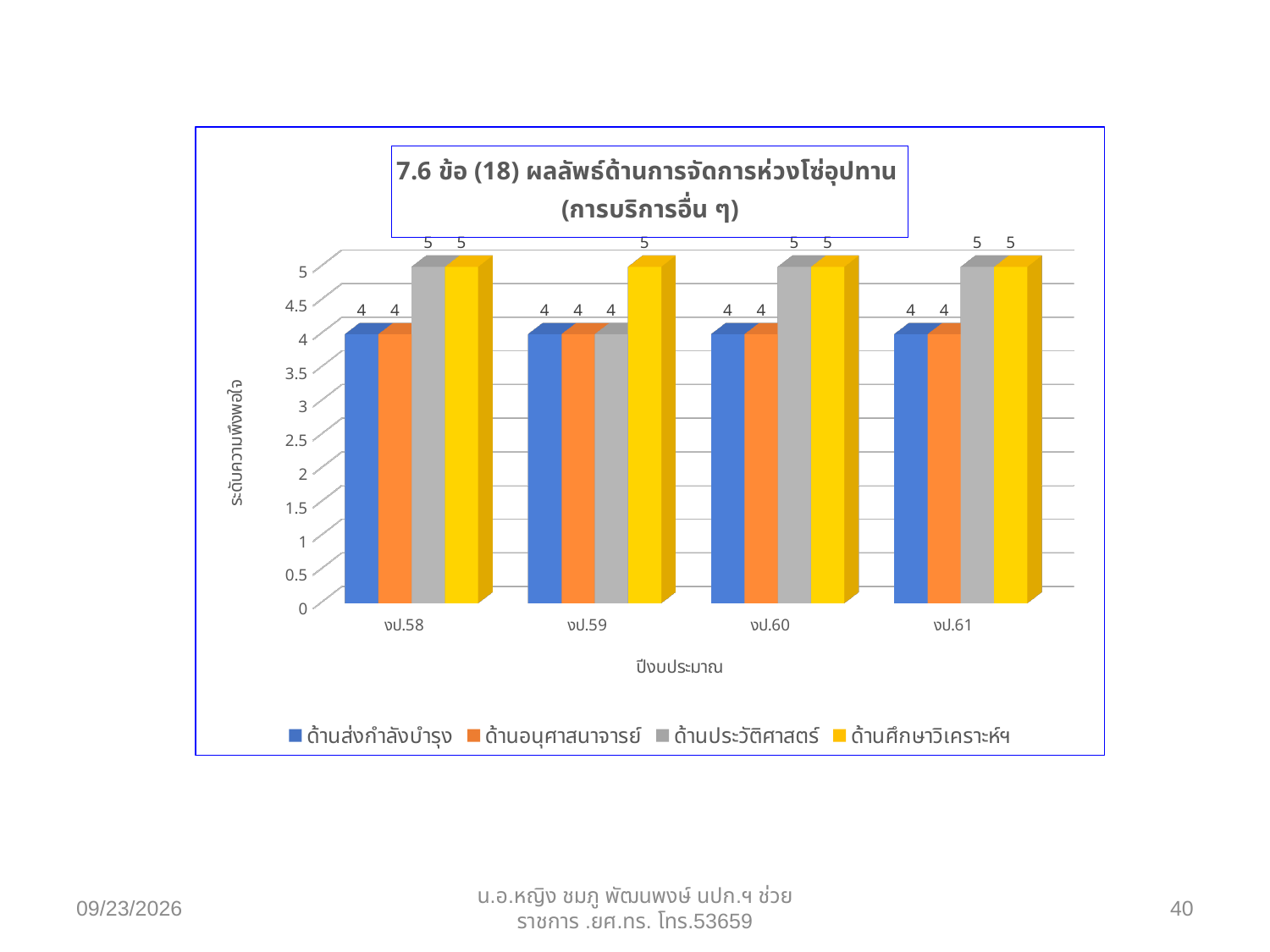
How many series does the legend list? 4 What is the value for ด้านประวัติศาสตร์ in งป.60? 5 What is the difference between ด้านศึกษาวิเคราะห์ฯ and ด้านอนุศาสนาจารย์ in งป.59? 1 What type of chart is shown on the slide? bar chart What is the value for ด้านส่งกำลังบำรุง in งป.61? 4 Which series has the lowest value in งป.59? ด้านส่งกำลังบำรุง, ด้านอนุศาสนาจารย์ and ด้านประวัติศาสตร์ (all 4) What is the value for ด้านศึกษาวิเคราะห์ฯ in งป.58? 5 How many fiscal-year categories are shown on the x axis? 4 Which is larger in งป.58: ด้านประวัติศาสตร์ or ด้านส่งกำลังบำรุง? ด้านประวัติศาสตร์ What is the label of the y axis? ระดับความพึงพอใจ What is the value for ด้านประวัติศาสตร์ in งป.59? 4 Does the value for ด้านอนุศาสนาจารย์ stay the same, rise, or fall across the fiscal years? stays the same